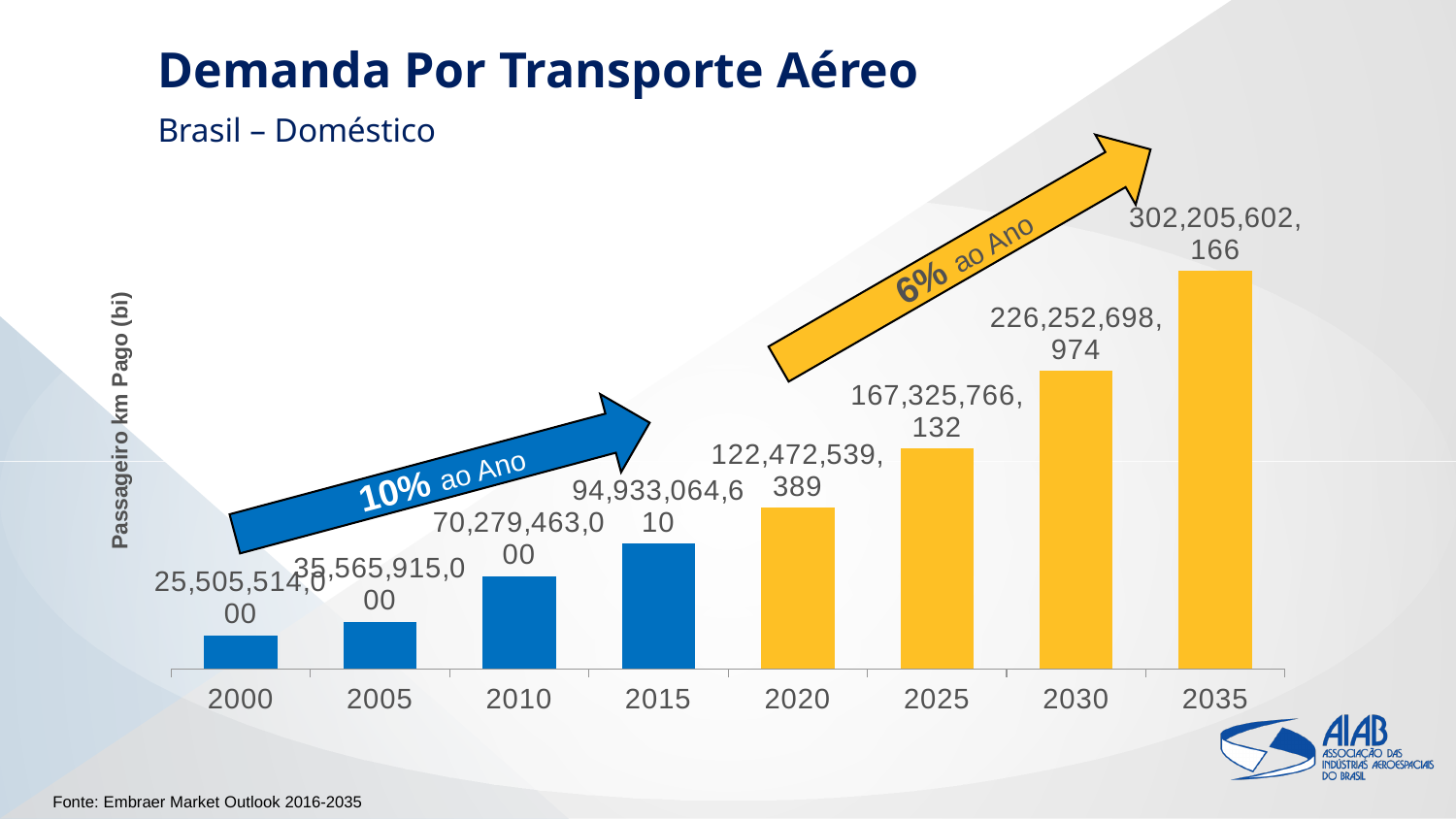
What type of chart is shown on the slide? Bar chart What is the label on the vertical axis of the chart? Passageiro km Pago (bi) Which year has the lowest value in the chart? 2000 What is the value shown for 2035? 302,205,602,166 What is the difference between the values for 2025 and 2020? 44,853,226,743 What is the difference between the values for 2035 and 2030? 75,952,903,192 What is the value shown for 2015? 94,933,064,610 What is the value shown for 2030? 226,252,698,974 Which year has the highest value in the chart? 2035 How many years (bars) are plotted in the chart? 8 What is the value shown for 2020? 122,472,539,389 Do the values rise or fall from 2000 to 2035? Rise